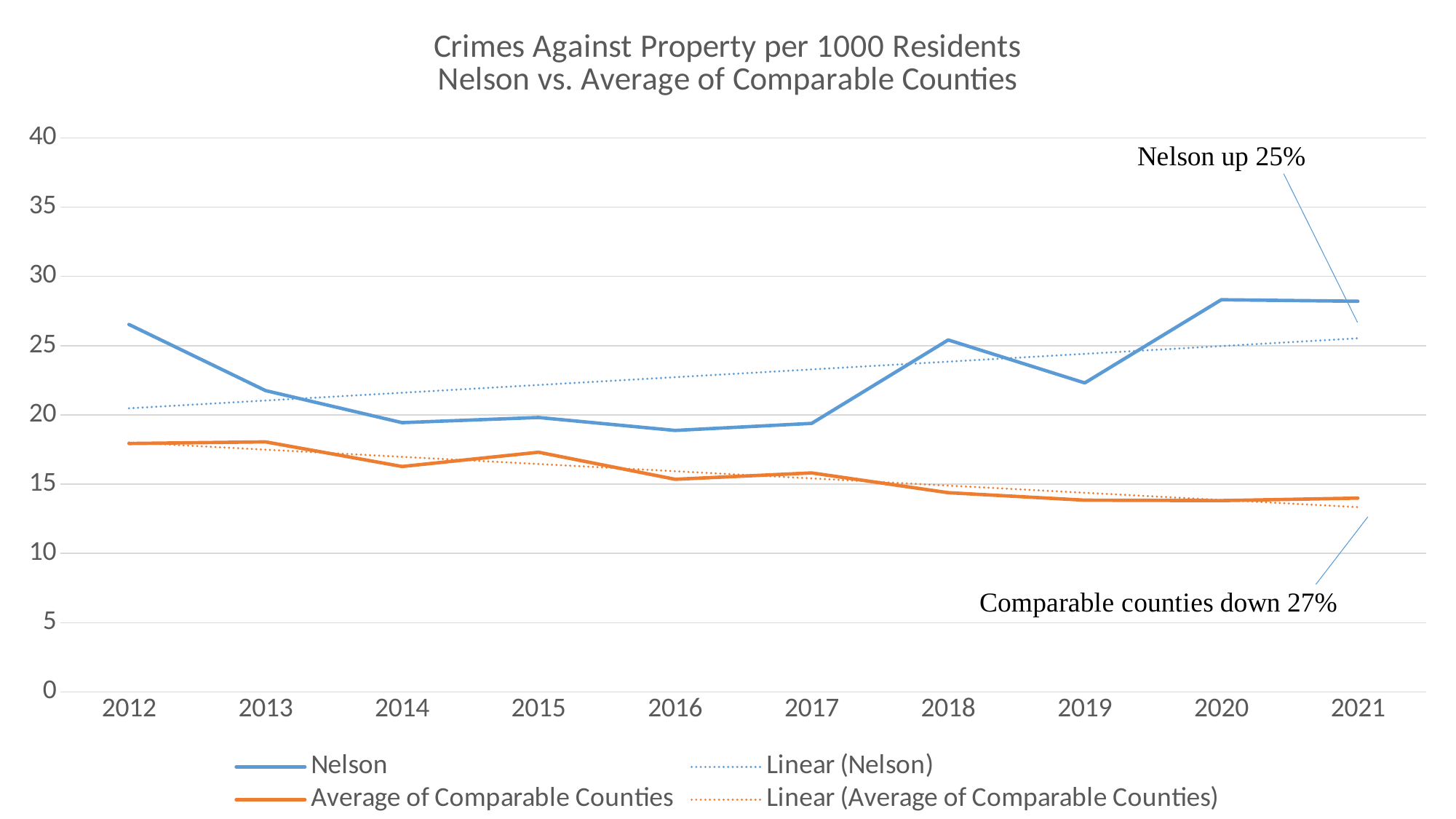
In 2021, which series is higher: Nelson or Average of Comparable Counties? Nelson Does the Average of Comparable Counties line generally rise or fall from 2012 to 2021? fall Is the Nelson value for 2012 greater or less than 25? greater How many years are plotted along the x axis? 10 Is the Nelson value for 2016 greater or less than 20? less Is the Nelson value for 2020 greater or less than 25? greater How many entries does the legend list? 4 What kind of chart is shown on the slide? line chart For Nelson, which year has the higher value: 2018 or 2019? 2018 According to the annotation on the chart, by what percentage is Nelson up? 25%